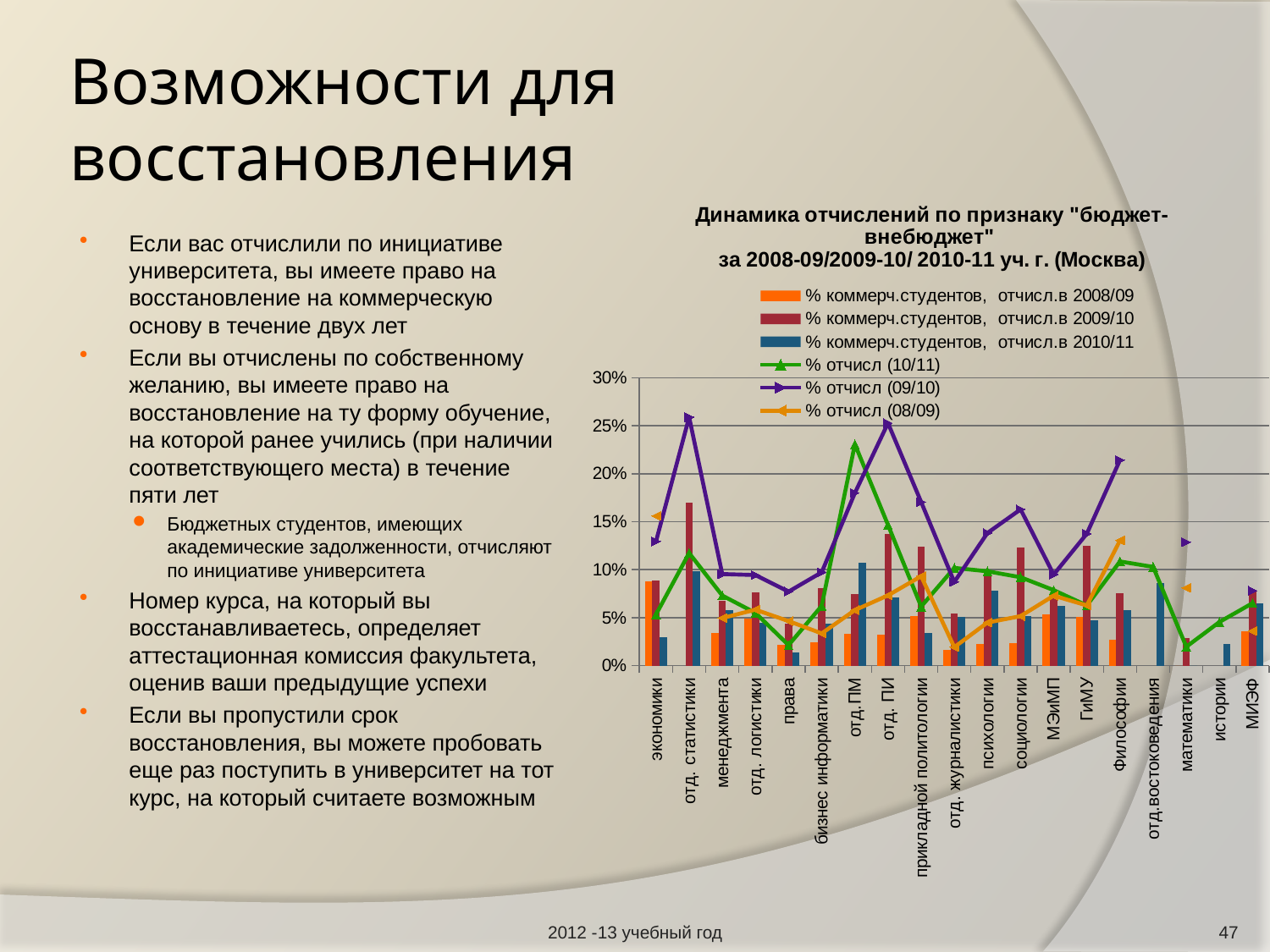
How many series does the chart legend list? 6 Is the value of "% отчисл (09/10)" for отд. статистики greater or less than 20%? greater What is the title of the chart? Динамика отчислений по признаку "бюджет-внебюджет" за 2008-09/2009-10/ 2010-11 уч. г. (Москва) What kind of chart is shown on the slide? Combined bar and line chart Is the value of "% коммерч.студентов, отчисл.в 2009/10" for права greater or less than 10%? less What colour represents the series "% коммерч.студентов, отчисл.в 2008/09" in the chart? Orange How many faculty/department categories are shown on the x axis of the chart? 19 Which is larger: the "% коммерч.студентов, отчисл.в 2009/10" value for отд. статистики or for экономики? отд. статистики Which category has the highest value for the series "% отчисл (10/11)"? отд.ПМ Which category has the highest value for the series "% коммерч.студентов, отчисл.в 2009/10"? отд. статистики Is the value of "% коммерч.студентов, отчисл.в 2009/10" for отд. статистики greater or less than 15%? greater